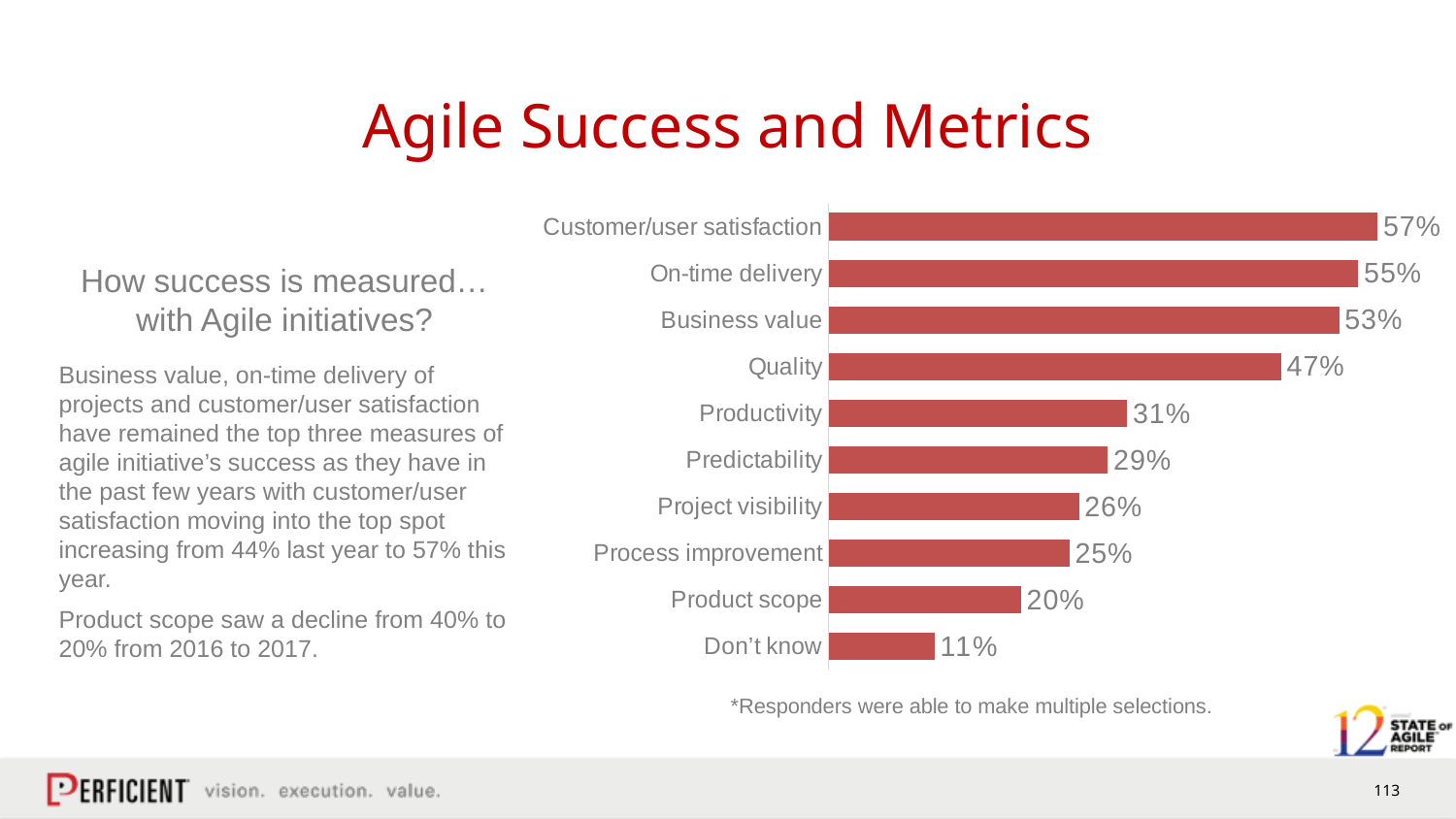
What percentage is shown for Customer/user satisfaction? 57% What colour are the bars in the chart? Red Which category has the highest value? Customer/user satisfaction What is the difference between On-time delivery and Business value? 2% What kind of chart is shown on the slide? Bar chart Which category has the lowest value? Don't know How many categories are shown in the chart? 10 What is the difference between Quality and Predictability? 18% Which is larger, Project visibility or Process improvement? Project visibility What is the value for Productivity? 31% What percentage is shown for Product scope? 20% What does the footnote below the chart say? *Responders were able to make multiple selections.